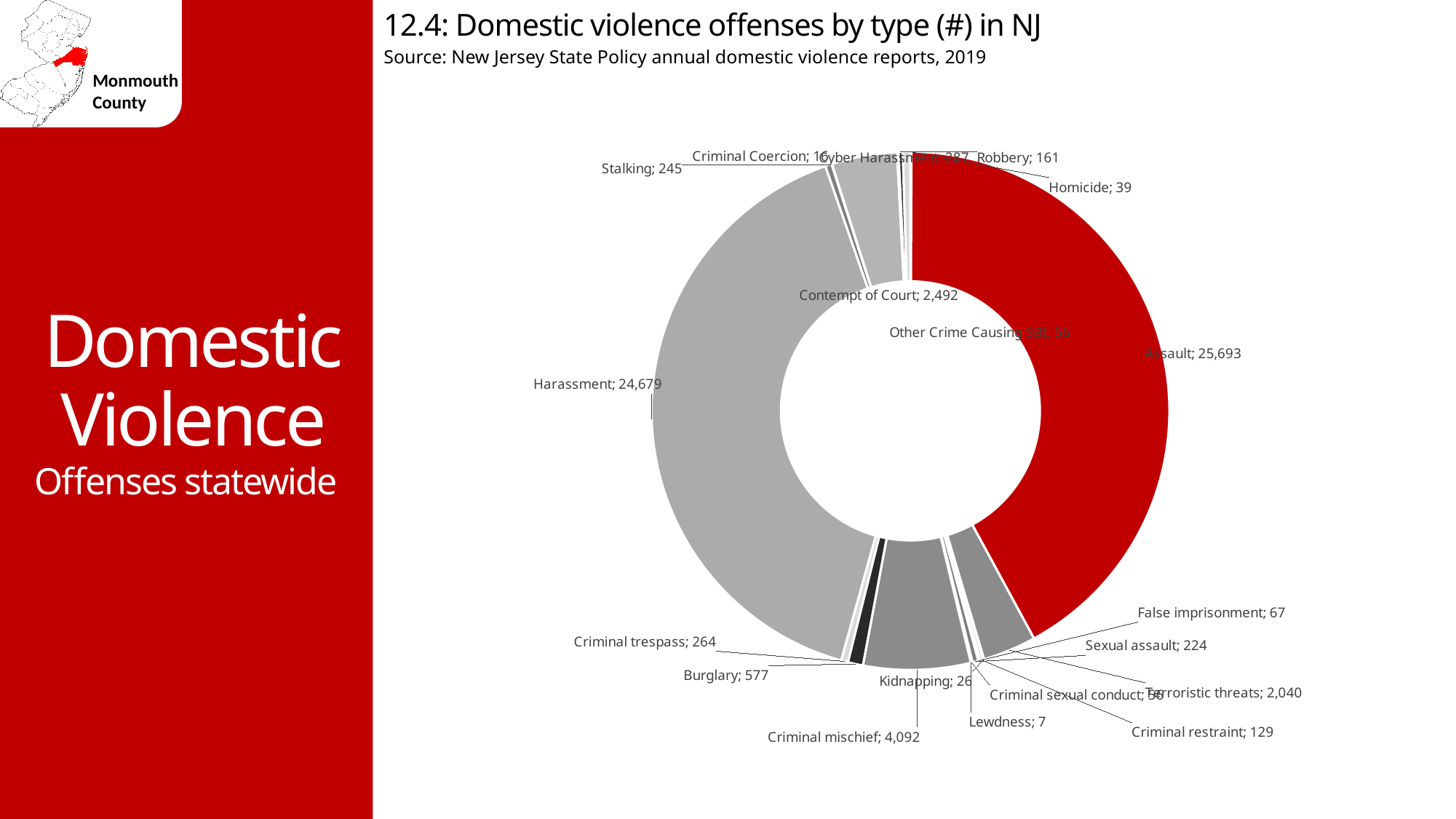
What is the value for Homicide? 39 What kind of chart is shown on the slide? Doughnut (pie) chart How many Assault offenses are shown? 25,693 What is the value for Terroristic threats? 2,040 How many Harassment offenses are shown? 24,679 Which offense type has the highest number of domestic violence offenses? Assault What is the value for Criminal mischief? 4,092 What is the title of the chart? 12.4: Domestic violence offenses by type (#) in NJ Which offense type has the lowest number of domestic violence offenses? Lewdness What is the difference between the Assault and Harassment values? 1,014 What is the value for Contempt of Court? 2,492 Which is larger, Burglary or Criminal trespass? Burglary